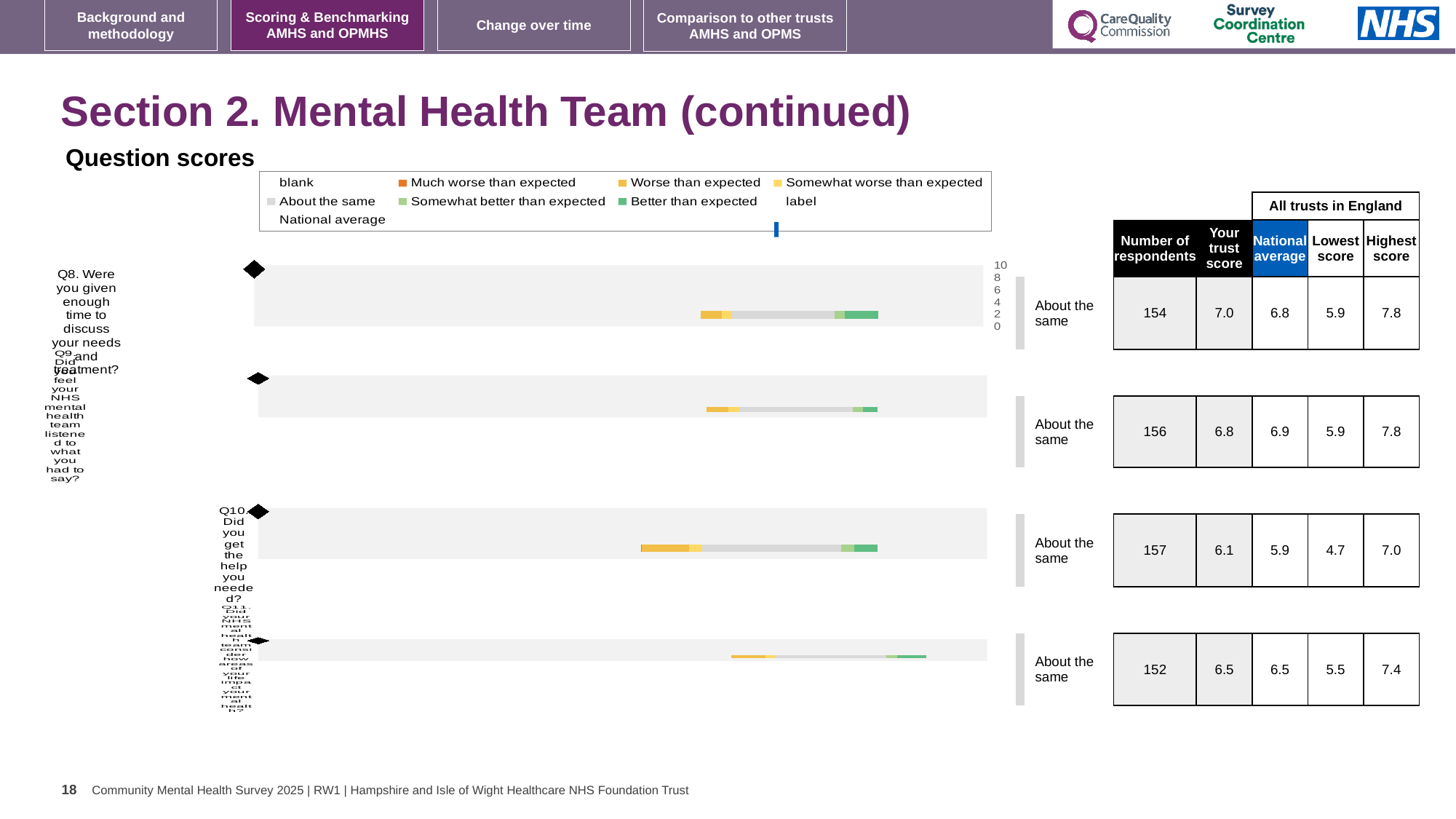
What kind of chart is used to show the question scores on this slide? bar chart For Q11, what is the Number of respondents shown in the table? 152 For Q10, what is the difference between the Highest score and the Lowest score? 2.3 What colour does the legend use for 'Much worse than expected'? orange For Q8, which is larger: Your trust score or the National average? Your trust score For Q9, what is the National average shown in the table? 6.9 What benchmark label is shown next to the Q8 chart? About the same What benchmark label is shown next to the Q10 chart? About the same What colour does the legend use for 'Better than expected'? green For Q10, what is the Lowest score shown in the table? 4.7 For Q8, what is 'Your trust score' shown in the table? 7.0 How many question charts (Q8 to Q11) are shown on the slide? 4